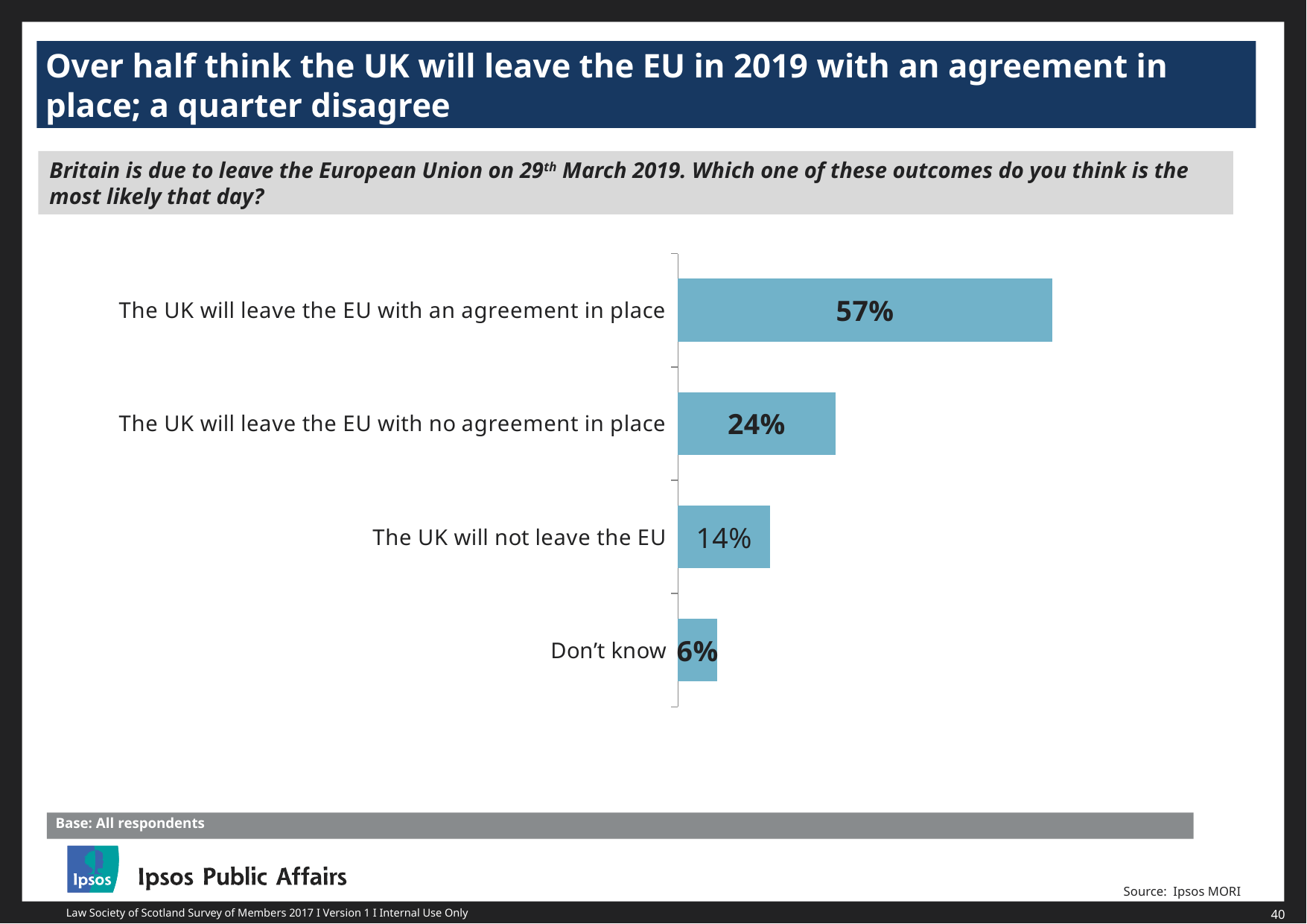
What percentage of respondents think the UK will leave the EU with an agreement in place? 57% What percentage of respondents answered 'Don't know'? 6% How many response categories are shown in the chart? 4 What is the difference in percentage points between 'The UK will leave the EU with no agreement in place' and 'The UK will not leave the EU'? 10 percentage points Which outcome has the highest percentage of respondents? The UK will leave the EU with an agreement in place What is the difference in percentage points between 'The UK will leave the EU with an agreement in place' and 'The UK will leave the EU with no agreement in place'? 33 percentage points Which is larger: the share who think the UK will not leave the EU, or the share who don't know? The UK will not leave the EU Which response has the lowest percentage? Don't know What type of chart is shown on the slide? Bar chart What percentage of respondents think the UK will leave the EU with no agreement in place? 24% What percentage of respondents think the UK will not leave the EU? 14% What is the base for the chart, as stated on the slide? All respondents